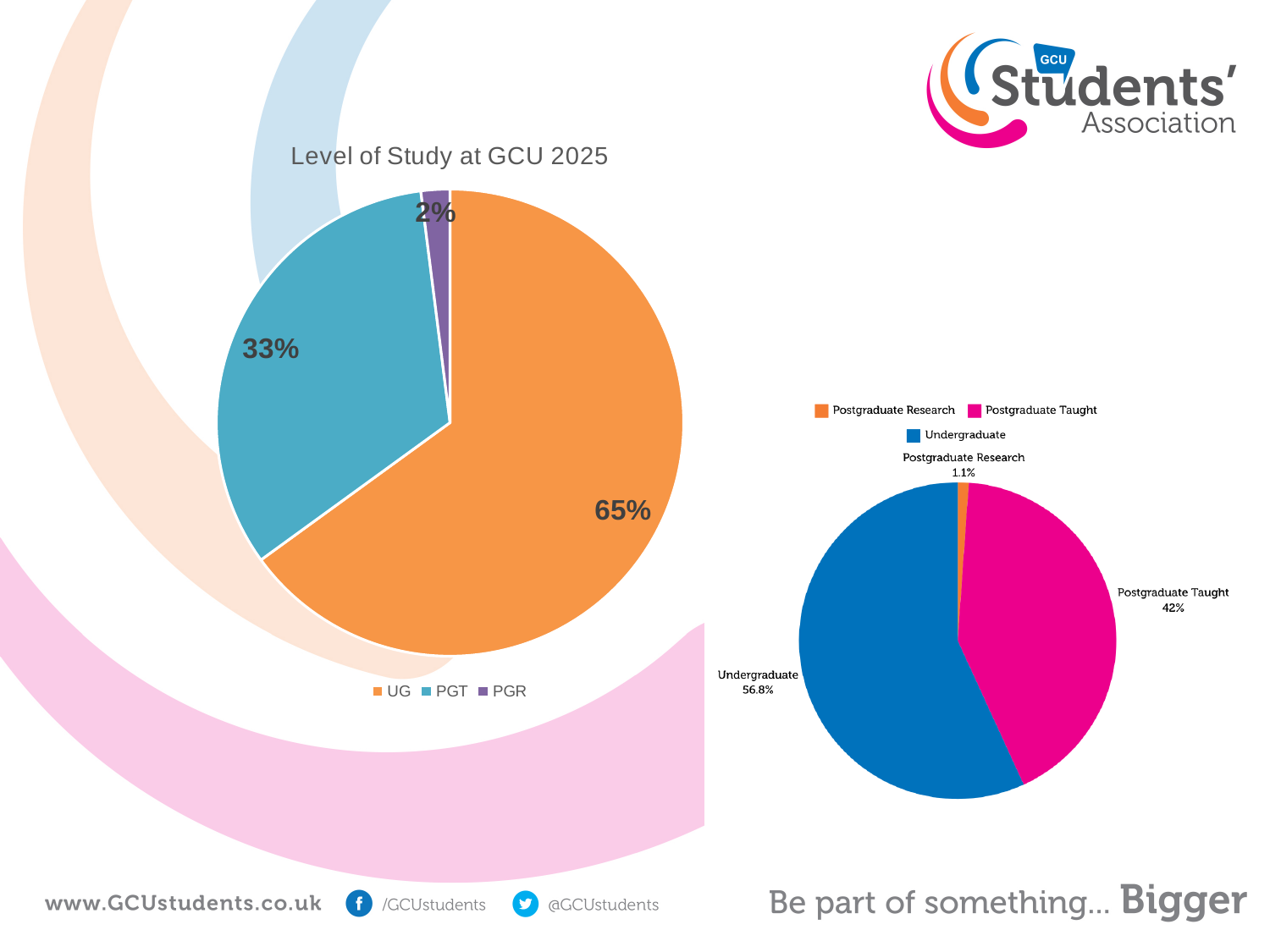
In the 'Level of Study at GCU 2025' chart, which category has the smallest slice? PGR In the pie chart on the right of the slide, which is larger, Undergraduate or Postgraduate Taught? Undergraduate In the pie chart on the right of the slide, what is the share for Undergraduate? 56.8% In the 'Level of Study at GCU 2025' chart, what share of the pie is PGR? 2% In the 'Level of Study at GCU 2025' chart, how many categories does the legend list? 3 In the 'Level of Study at GCU 2025' chart, what is the difference between the UG and PGT shares? 32% In the 'Level of Study at GCU 2025' chart, which category has the largest slice? UG In the pie chart on the right of the slide, what is the share for Postgraduate Taught? 42% What kind of chart is the 'Level of Study at GCU 2025' chart? Pie chart In the 'Level of Study at GCU 2025' chart, what share of the pie is UG? 65% In the 'Level of Study at GCU 2025' chart, what share of the pie is PGT? 33% In the pie chart on the right of the slide, what is the share for Postgraduate Research? 1.1%